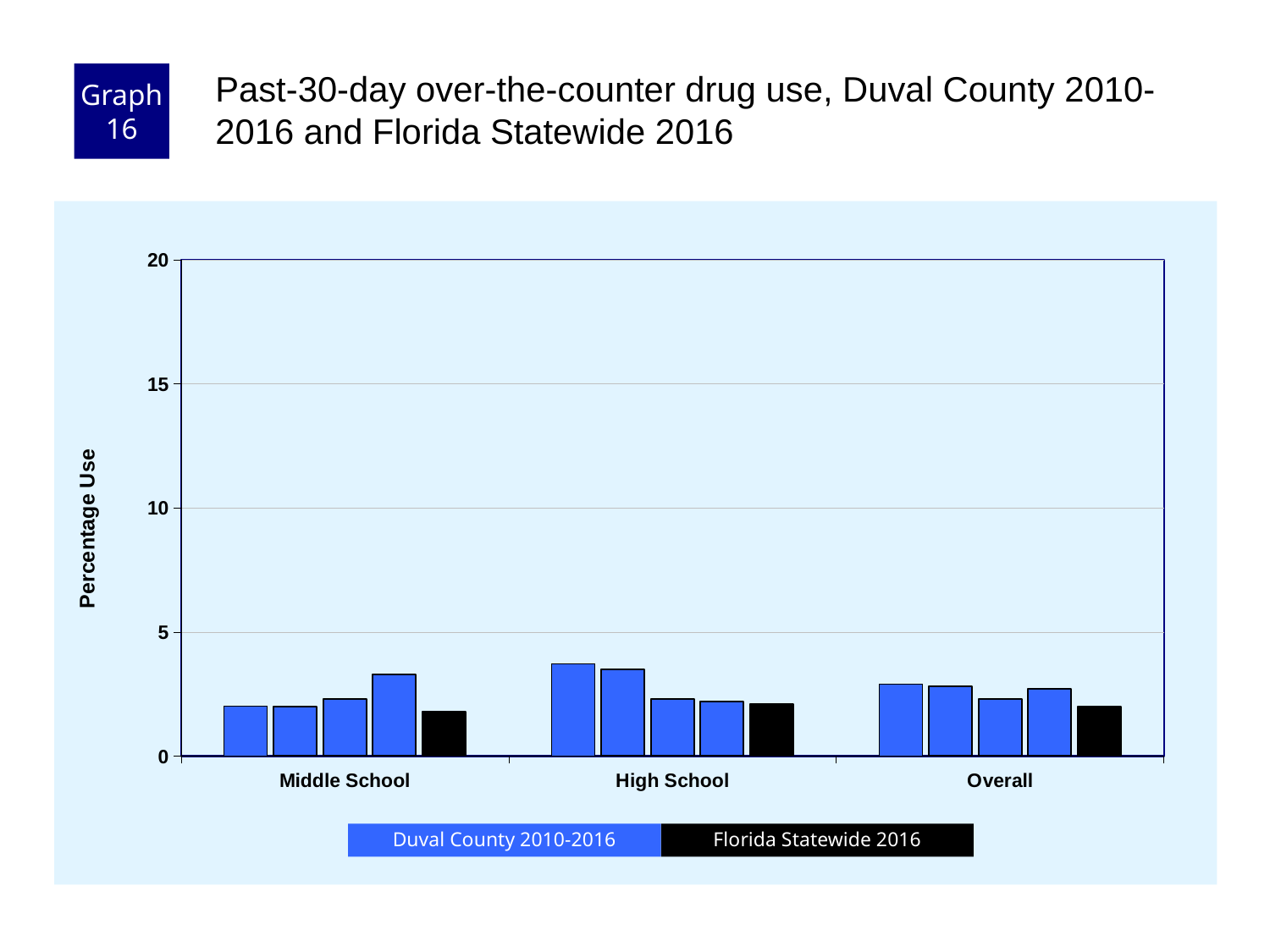
Is the highest bar in the Middle School group greater or less than 5? less Do the Duval County 2010-2016 bars in the Middle School group rise or fall from left to right? rise What is the label on the y axis? Percentage Use How many series does the legend list? 2 What kind of chart is shown on the slide? bar chart How many categories are shown along the x axis? 3 In the High School group, which is larger: the first Duval County bar or the Florida Statewide 2016 bar? the first Duval County bar Do the Duval County 2010-2016 bars in the High School group rise or fall from left to right? fall Are any of the bars on the chart greater than 10? no Is the Florida Statewide 2016 value for High School greater or less than 5? less In the Middle School group, which is larger: the last Duval County bar or the Florida Statewide 2016 bar? the last Duval County bar Which colour represents Florida Statewide 2016 in the legend? black